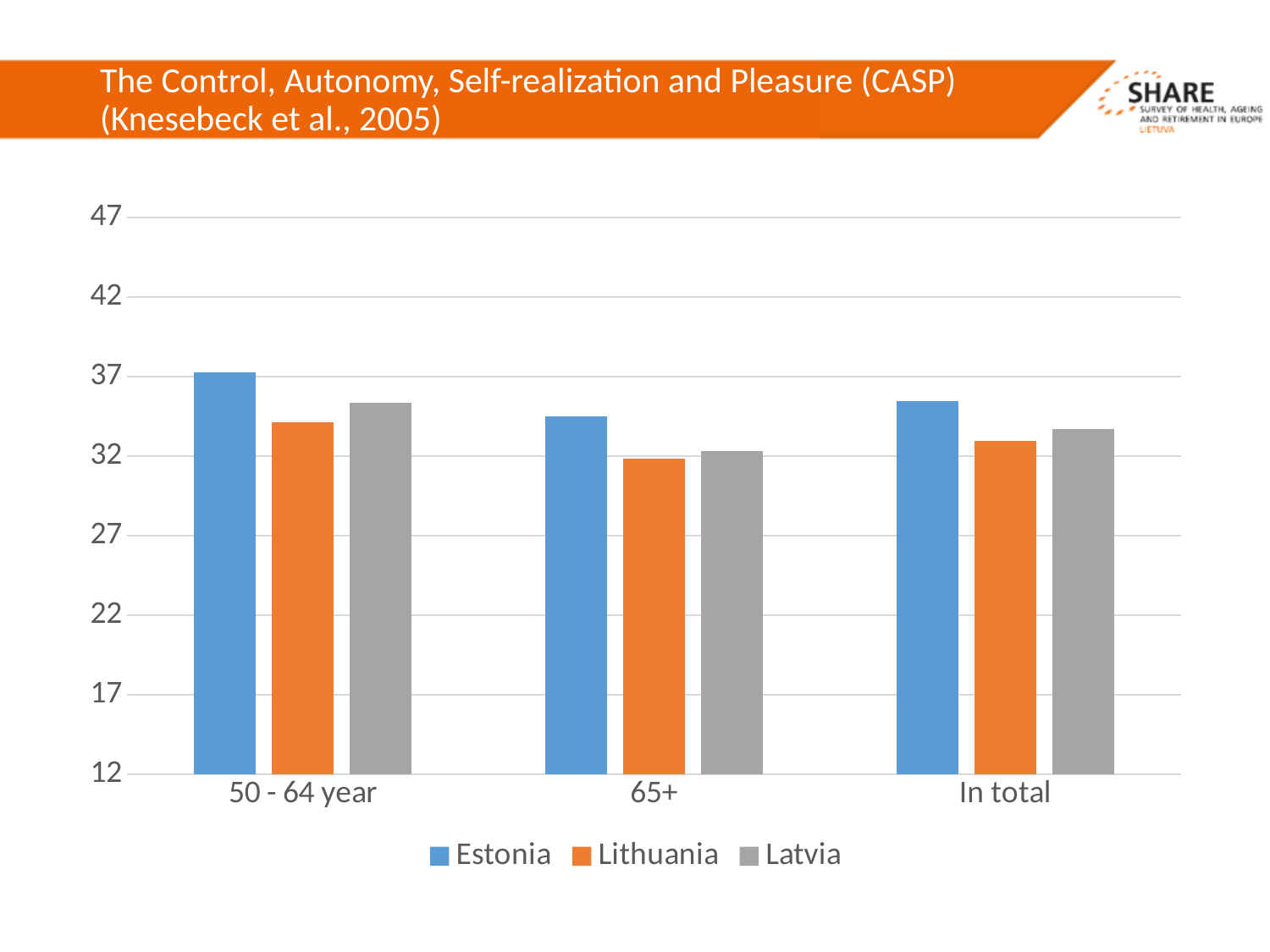
Which country has the highest value in the In total group? Estonia Is the value for Lithuania in the 50 - 64 year group greater or less than 32? greater How many series does the legend list? 3 Which country has the lowest value in the 50 - 64 year group? Lithuania How many categories are shown on the x axis? 3 Is the value for Estonia in the In total group greater or less than 37? less Which colour represents Lithuania in the legend? orange What kind of chart is shown on the slide? bar chart Does the value for Estonia rise or fall from the 50 - 64 year group to the 65+ group? fall Which country has the highest value in the 50 - 64 year group? Estonia Is the value for Estonia in the 65+ group greater or less than 32? greater In the 65+ group, which is larger, the value for Estonia or the value for Lithuania? Estonia